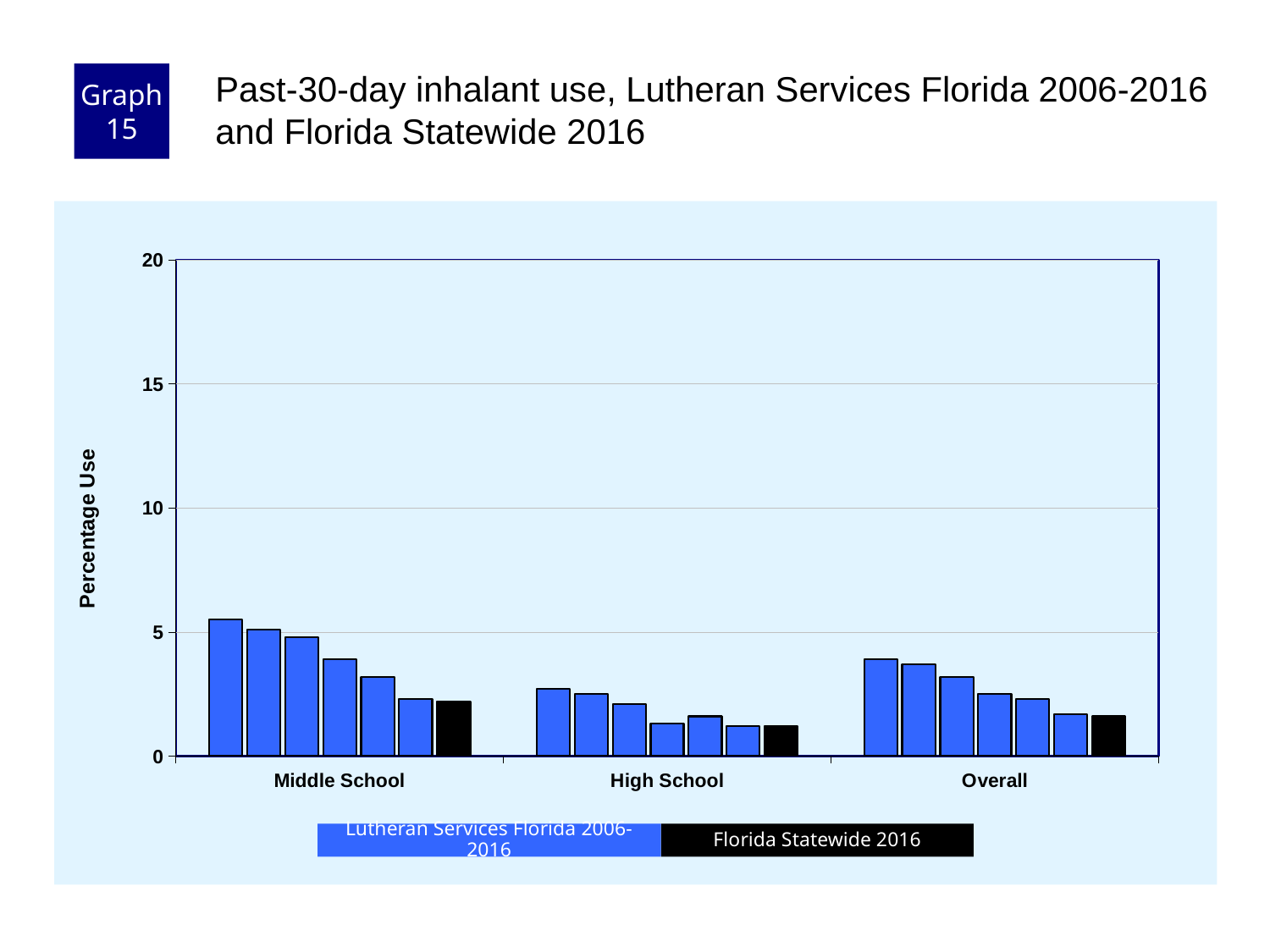
How many series does the legend list? 2 Is the tallest bar in the Middle School group greater or less than 5? greater Is the Florida Statewide 2016 value for Middle School greater or less than 5? less How many categories are shown on the x axis? 3 How many bars are plotted in the Middle School group? 7 What kind of chart is shown on the slide? bar chart Which category group has the lowest bars overall? High School Is the tallest bar in the Overall group greater or less than 5? less What is the label on the y axis? Percentage Use Do the Lutheran Services Florida bars in the Middle School group rise or fall from left to right? fall Which category group contains the tallest bar on the chart? Middle School